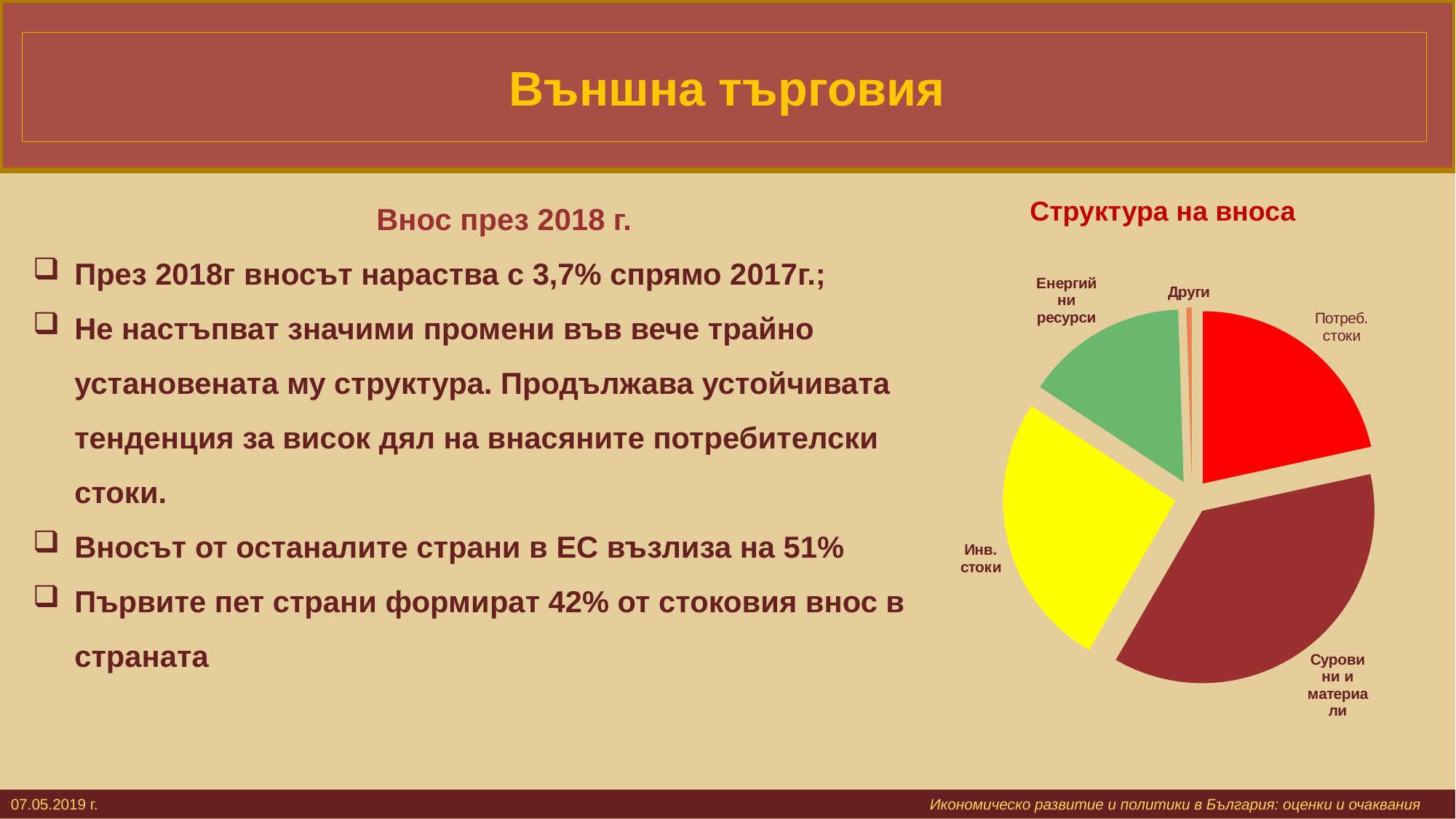
What is the title of the chart on the slide? Структура на вноса Which category has the largest slice in the pie chart? Суровини и материали What colour is the slice for Инв. стоки? yellow What kind of chart is shown on the slide? pie chart How many slices does the pie chart have? 5 Which slice is larger: Инв. стоки or Енергийни ресурси? Инв. стоки Which category has the smallest slice in the pie chart? Други Which slice is larger: Суровини и материали or Потреб. стоки? Суровини и материали Which slice is larger: Други or Енергийни ресурси? Енергийни ресурси